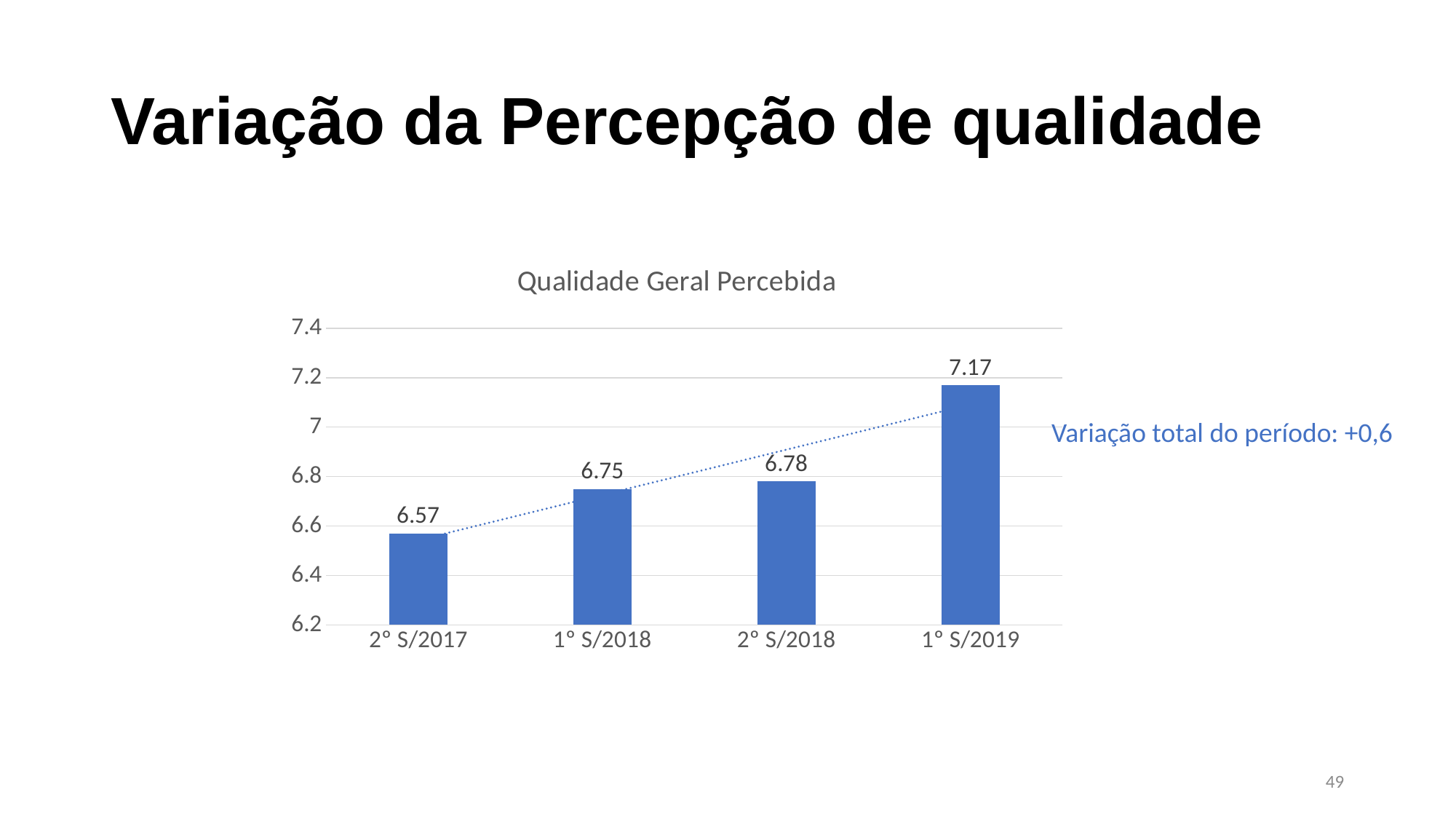
Which period has the lowest value? 2° S/2017 What is the difference between the values for 1° S/2019 and 2° S/2017? 0.6 What is the value for 1° S/2018? 6.75 What kind of chart is this? bar chart How many periods are shown on the x axis? 4 Is the value for 1° S/2019 greater or less than 7? greater Which period has the highest value? 1° S/2019 Which is larger, the value for 1° S/2018 or the value for 1° S/2019? 1° S/2019 What is the value for 2° S/2017? 6.57 What is the value for 2° S/2018? 6.78 What is the title of the chart? Qualidade Geral Percebida What is the value for 1° S/2019? 7.17